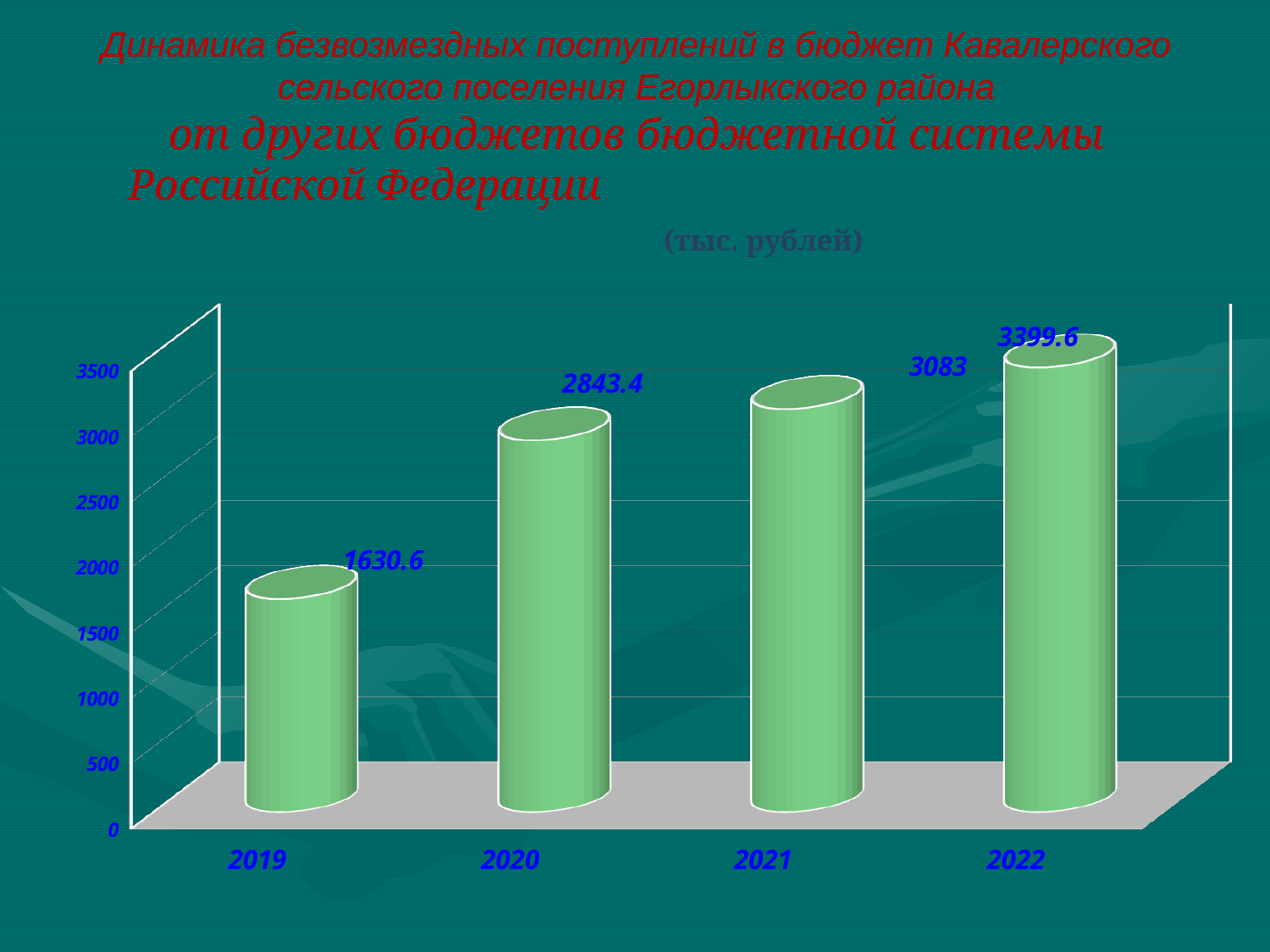
What is the value for 2021? 3083 Which is larger, the value for 2021 or the value for 2020? 2021 What is the difference between the values for 2022 and 2019? 1769 How many years are shown on the chart? 4 What kind of chart is shown on the slide? bar chart What is the value for 2020? 2843.4 Which year has the highest value? 2022 What is the value for 2019? 1630.6 Do the values rise or fall from 2019 to 2022? rise What is the value for 2022? 3399.6 Which year has the lowest value? 2019 What is the difference between the values for 2020 and 2019? 1212.8